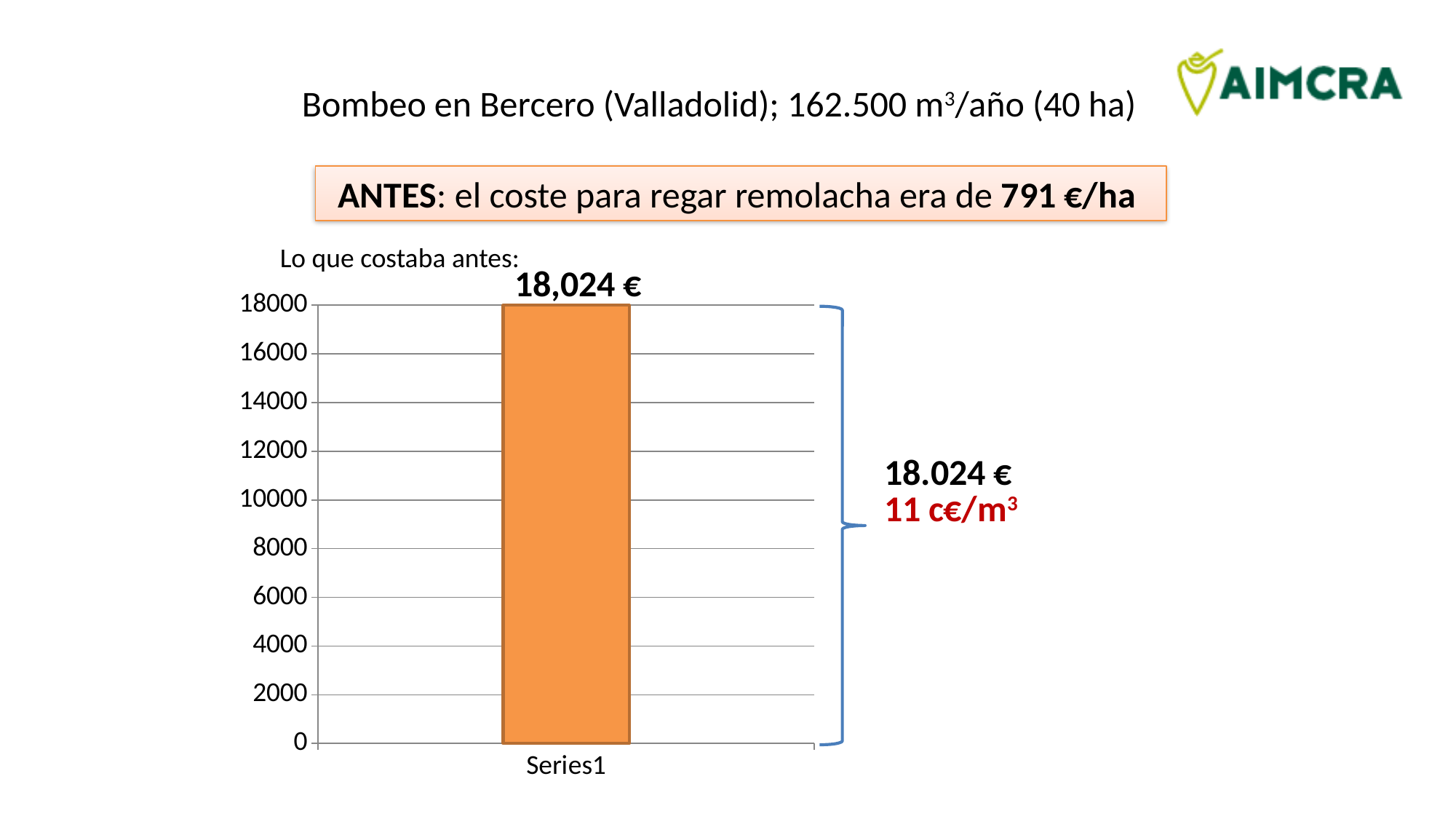
What kind of chart is shown on the slide? bar chart Is the value for Series1 greater or less than 16000? greater What is the title text shown above the chart? Lo que costaba antes: How many bars are plotted in the chart? 1 What is the value shown by the data label on the Series1 bar? 18,024 € What is the highest value shown on the y axis of the chart? 18000 Is the value for Series1 greater or less than 10000? greater What is the category label shown on the x axis of the chart? Series1